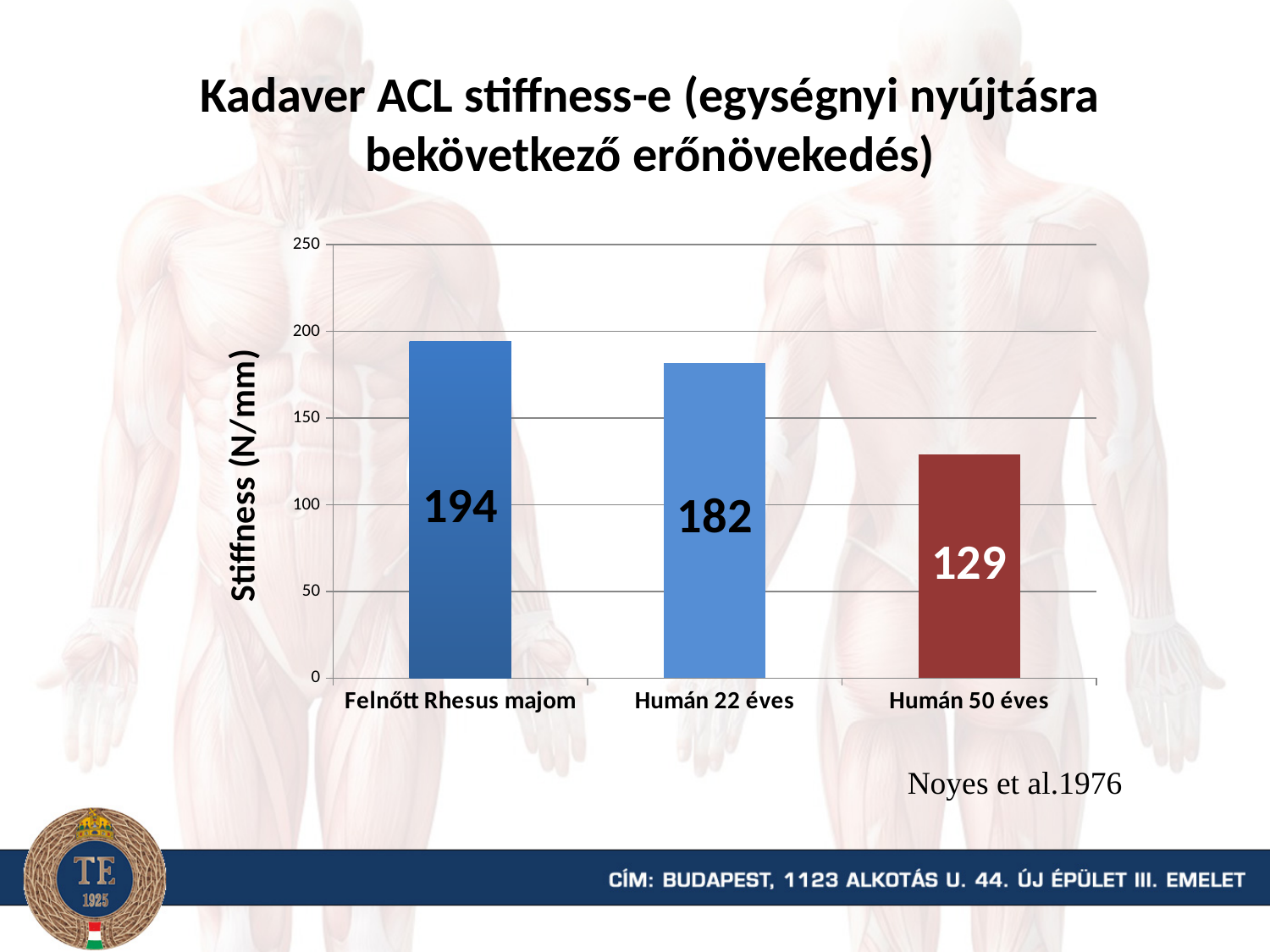
What kind of chart is shown on the slide? bar chart What is the stiffness value for Humán 50 éves? 129 Which category has the lowest stiffness? Humán 50 éves What is the stiffness value for Felnőtt Rhesus majom? 194 Which has a larger stiffness value, Humán 22 éves or Humán 50 éves? Humán 22 éves What is the difference in stiffness between Felnőtt Rhesus majom and Humán 50 éves? 65 How many categories are shown in the chart? 3 Which category has the highest stiffness? Felnőtt Rhesus majom What is the difference in stiffness between Humán 22 éves and Humán 50 éves? 53 Is the value for Humán 50 éves greater or less than 150? less What is the label of the vertical axis? Stiffness (N/mm) What is the stiffness value for Humán 22 éves? 182